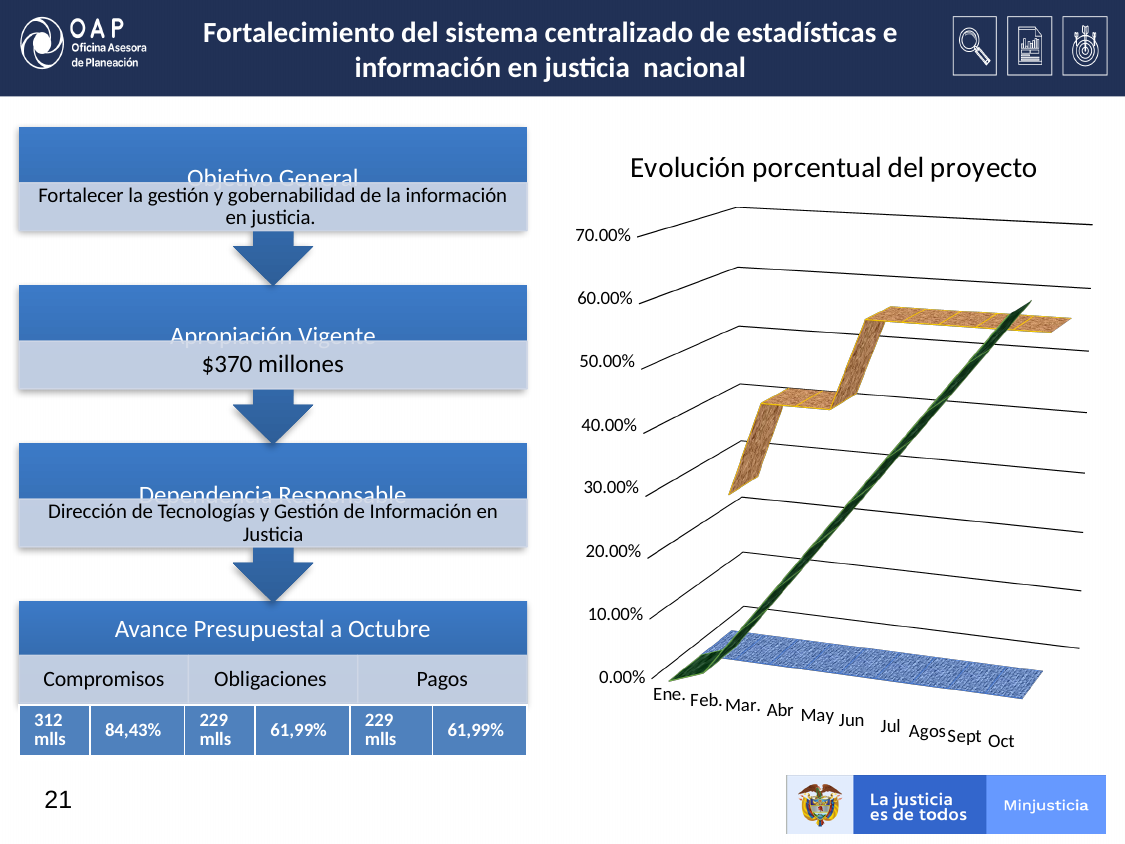
How many series are plotted in the chart? 3 What is the highest value shown on the vertical axis of the chart? 70.00% Is the value of the blue series in the chart greater or less than 10.00% across the months? less What is the first category on the x axis of the chart? Ene. How many months are shown along the x axis of the chart? 10 What is the title of the chart on the right side of the slide? Evolución porcentual del proyecto Is the value of the green series at Oct greater or less than 30.00%? greater Does the green series in the chart rise or fall from Ene. to Oct? rise What is the last category on the x axis of the chart? Oct What kind of chart is 'Evolución porcentual del proyecto'? 3D line chart